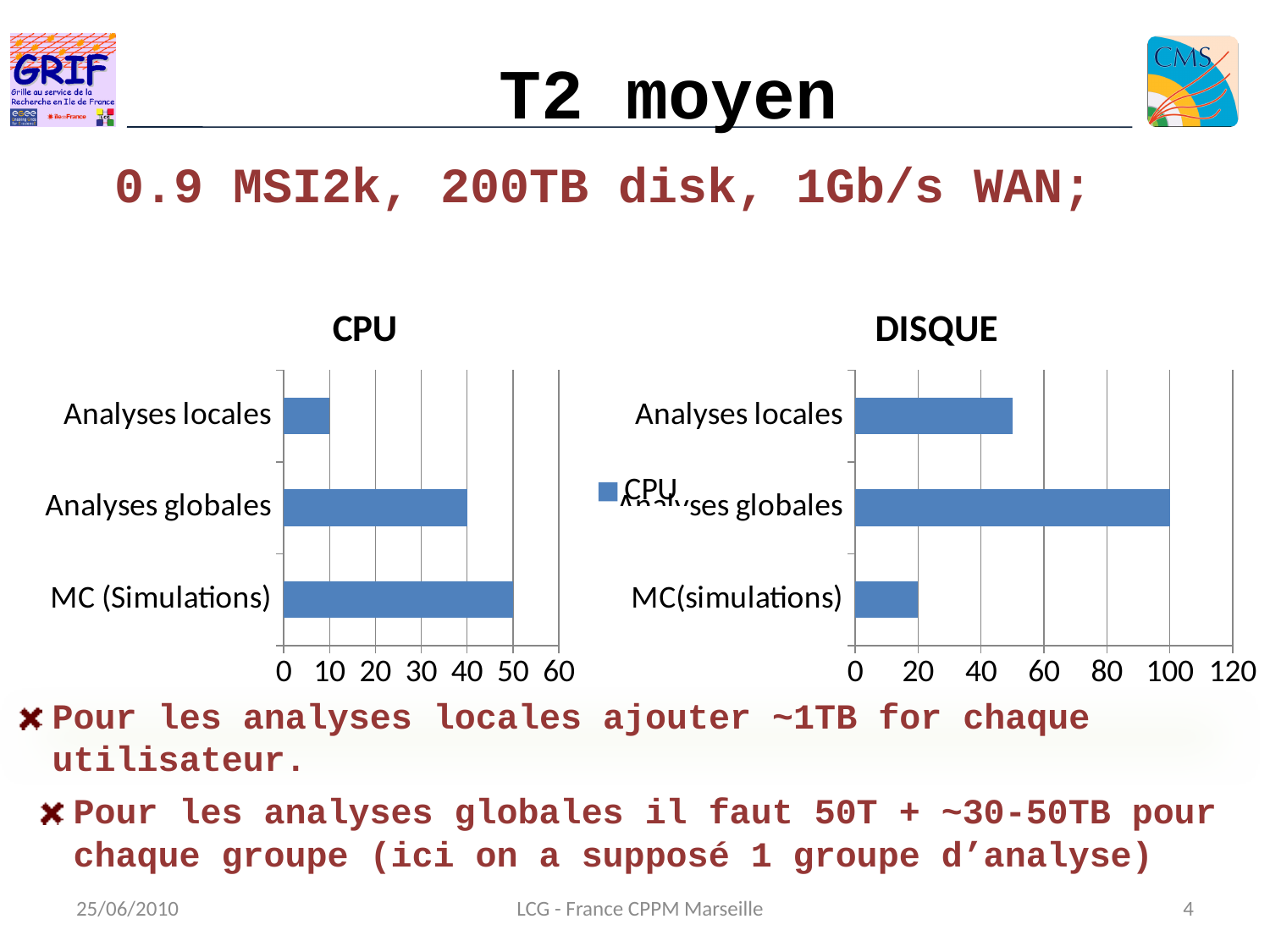
In the CPU chart, which category has the highest value? MC (Simulations) In the CPU chart, which category has the lowest value? Analyses locales In the CPU chart, what is the value for MC (Simulations)? 50 In the CPU chart, what is the value for Analyses globales? 40 What kind of chart is the CPU chart? bar chart How many series does the legend of the CPU chart list? 1 In the DISQUE chart, which is larger, the value for Analyses locales or the value for MC(simulations)? Analyses locales In the DISQUE chart, what is the value for Analyses globales? 100 In the CPU chart, how many categories are shown? 3 In the DISQUE chart, is the value for Analyses locales greater or less than 40? greater In the DISQUE chart, which category has the highest value? Analyses globales In the DISQUE chart, which category has the lowest value? MC(simulations)